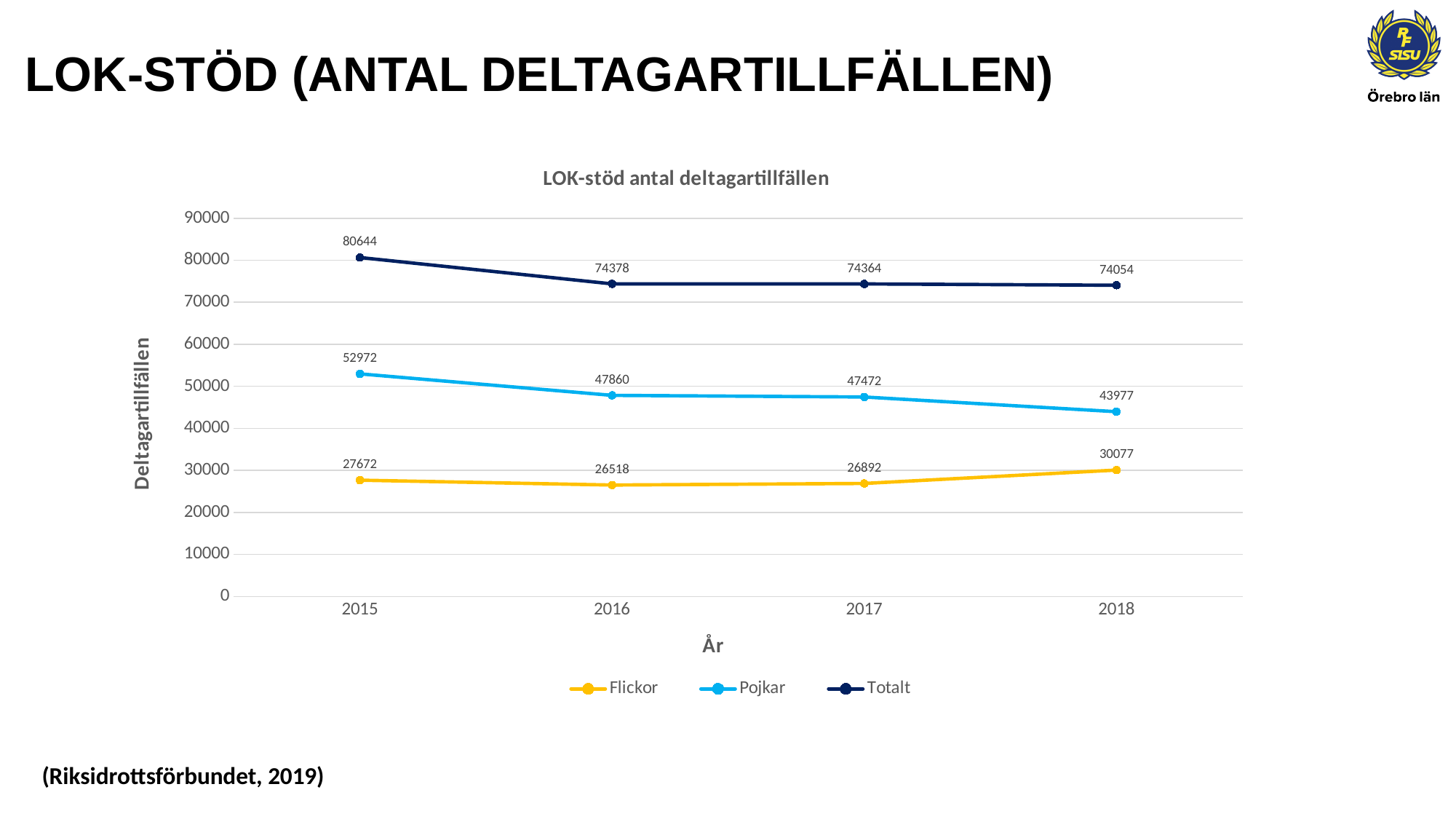
Which is larger, the Flickor value in 2017 or the Flickor value in 2018? 2018 In which year is the Pojkar series lowest? 2018 In which year is the Flickor series highest? 2018 What is the value for Flickor in 2016? 26518 Does the Totalt series rise or fall from 2015 to 2018? fall Is the value for Totalt in 2018 greater or less than 70000? greater How many years are shown on the x axis? 4 What is the difference between the Pojkar value in 2015 and in 2016? 5112 What kind of chart is shown? line chart What is the value for Totalt in 2015? 80644 What is the value for Pojkar in 2018? 43977 How many series does the legend list? 3